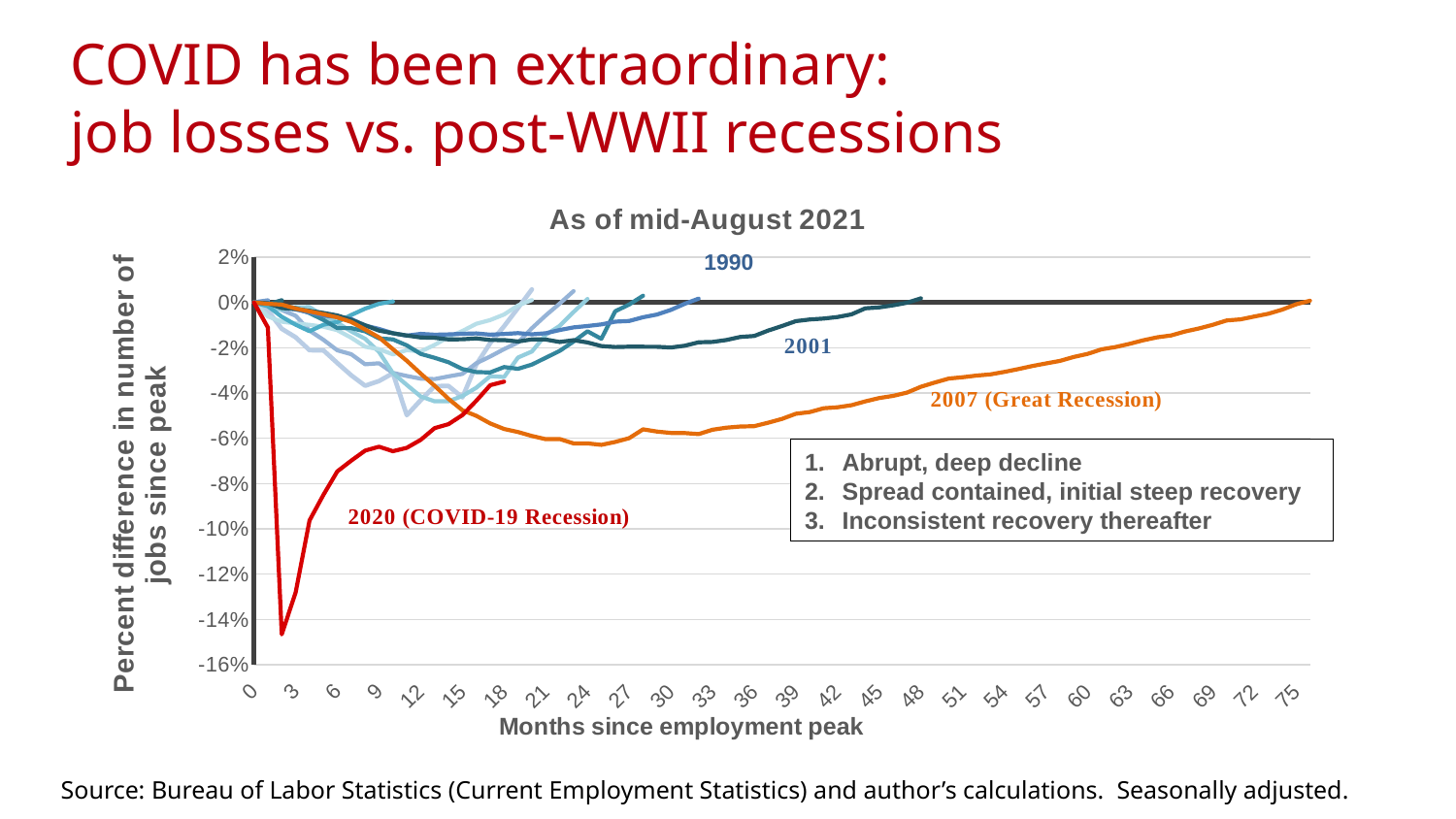
Is the lowest value of the 1990 line greater or less than -2%? greater What is the largest value shown on the x axis? 75 Does the 2007 (Great Recession) line rise or fall between month 30 and month 75? rise Is the lowest value of the 2020 (COVID-19 Recession) line greater or less than -14%? less What kind of chart is shown on the slide? line chart Which line takes the most months to return to 0%: 2001 or 2007 (Great Recession)? 2007 (Great Recession) What is the label of the x axis of the chart? Months since employment peak Which line has a deeper low point: 2001 or 2020 (COVID-19 Recession)? 2020 (COVID-19 Recession) What is the lowest value shown on the y axis? -16% Which labeled recession line reaches the lowest value on the chart? 2020 (COVID-19 Recession) What is the title of the chart? As of mid-August 2021